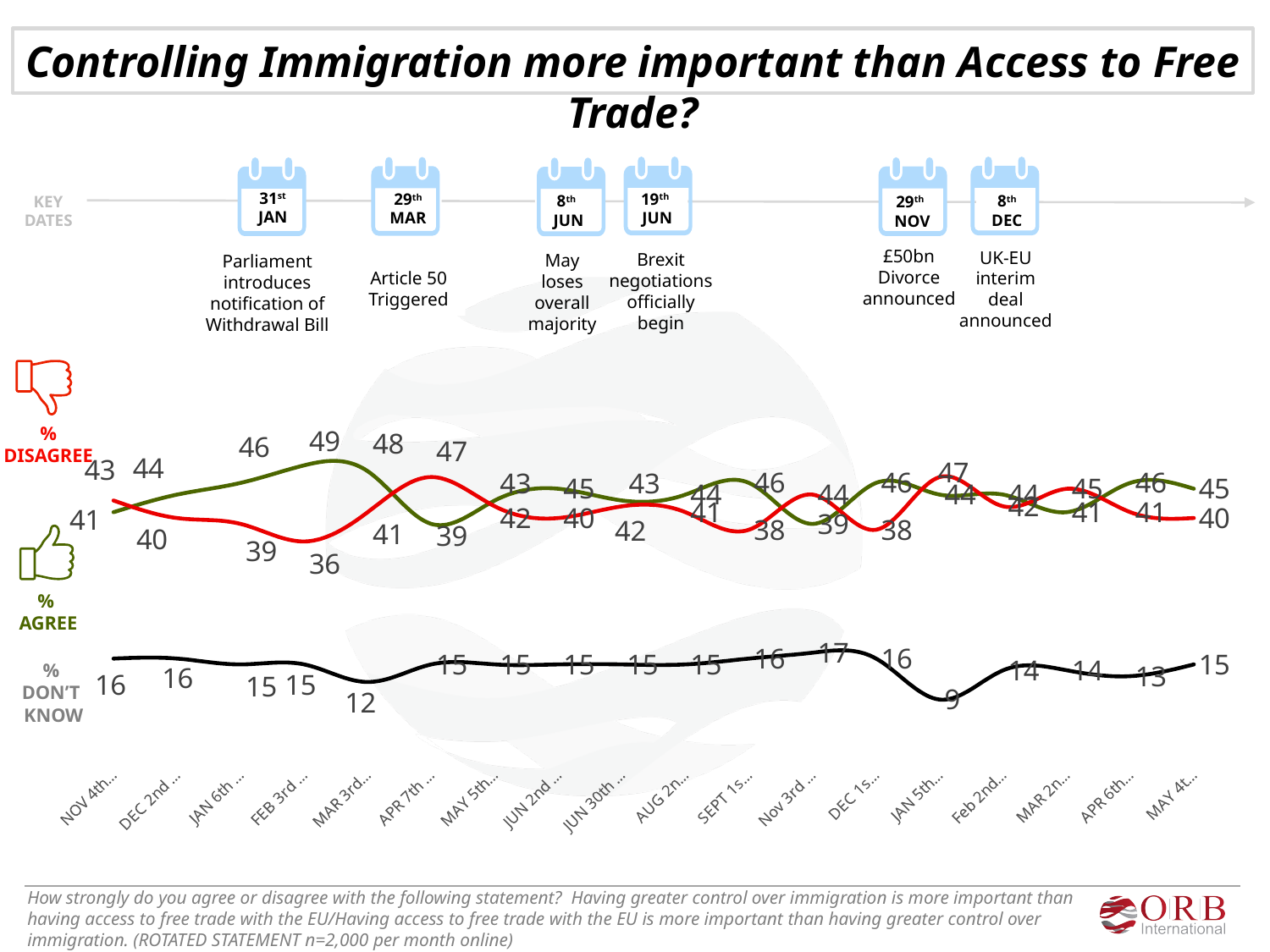
How many dates are shown along the x axis of the chart? 18 What is the % Disagree value at Apr 7th? 47 What is the % Don't Know value at Jan 5th? 9 What is the difference between % Agree and % Disagree at Feb 3rd? 13 At which date does the % Agree series reach its highest value? Feb 3rd What kind of chart is shown on the slide? line chart At which date is the % Don't Know series at its lowest? Jan 5th How many series are plotted on the chart? 3 What is the % Don't Know value at Mar 3rd? 12 At which date does the % Disagree series reach its lowest value? Feb 3rd What colour is the % Disagree line? red At Sept 1st, which is larger: % Agree or % Disagree? % Agree